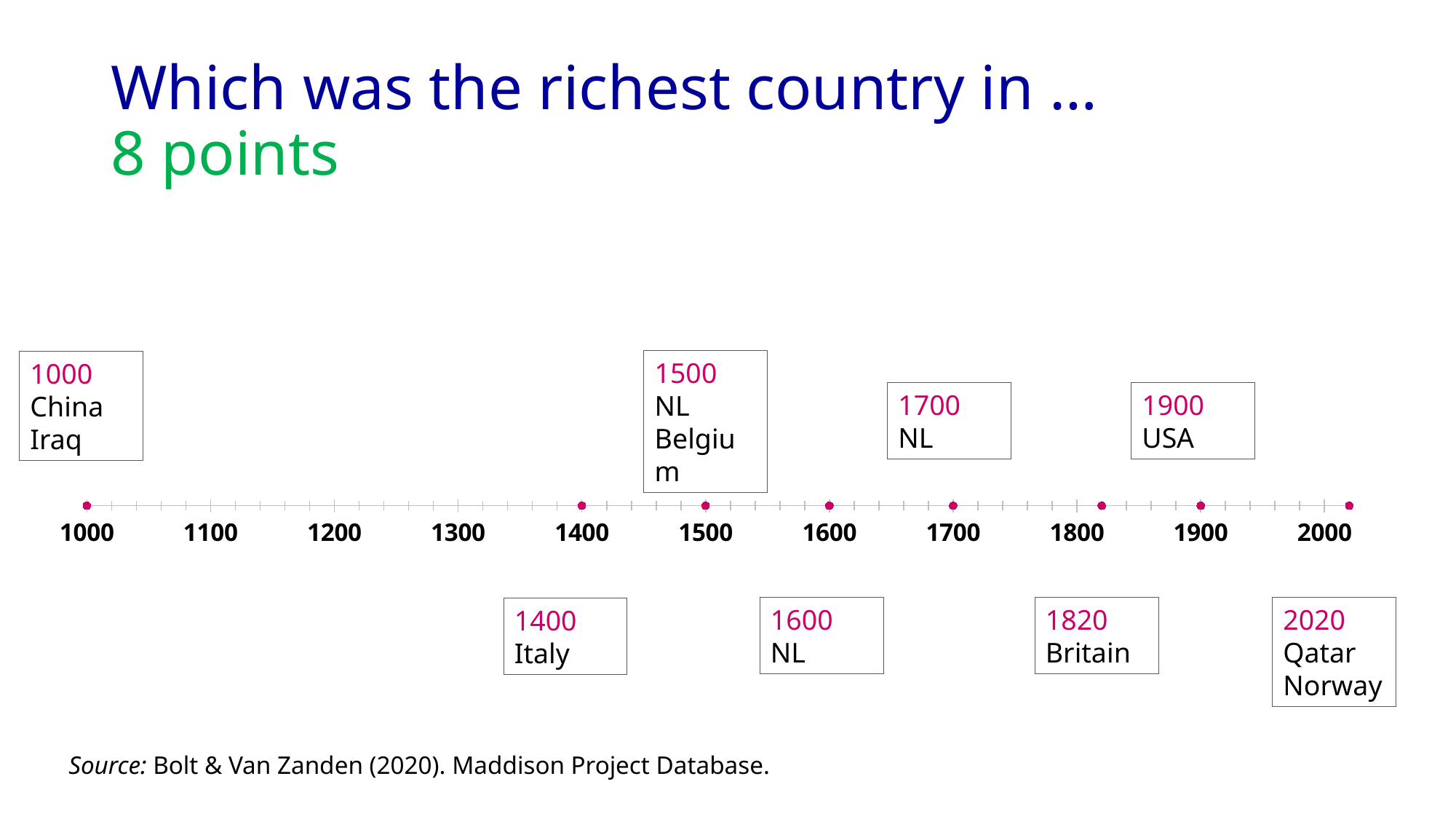
How many points are marked on the timeline? 8 Which countries are labelled as the richest in 1000 on the timeline? China, Iraq Which country is labelled as the richest in 1820 on the timeline? Britain What is the latest year marked with a point on the timeline? 2020 What kind of chart is shown on the slide? Timeline Which country is labelled as the richest in 1600 on the timeline? NL Which country is labelled as the richest in 1700 on the timeline? NL What is the earliest year marked with a point on the timeline? 1000 Which countries are labelled as the richest in 1500 on the timeline? NL, Belgium Which countries are labelled as the richest in 2020 on the timeline? Qatar, Norway Which country is labelled as the richest in 1900 on the timeline? USA Which country is labelled as the richest in 1400 on the timeline? Italy